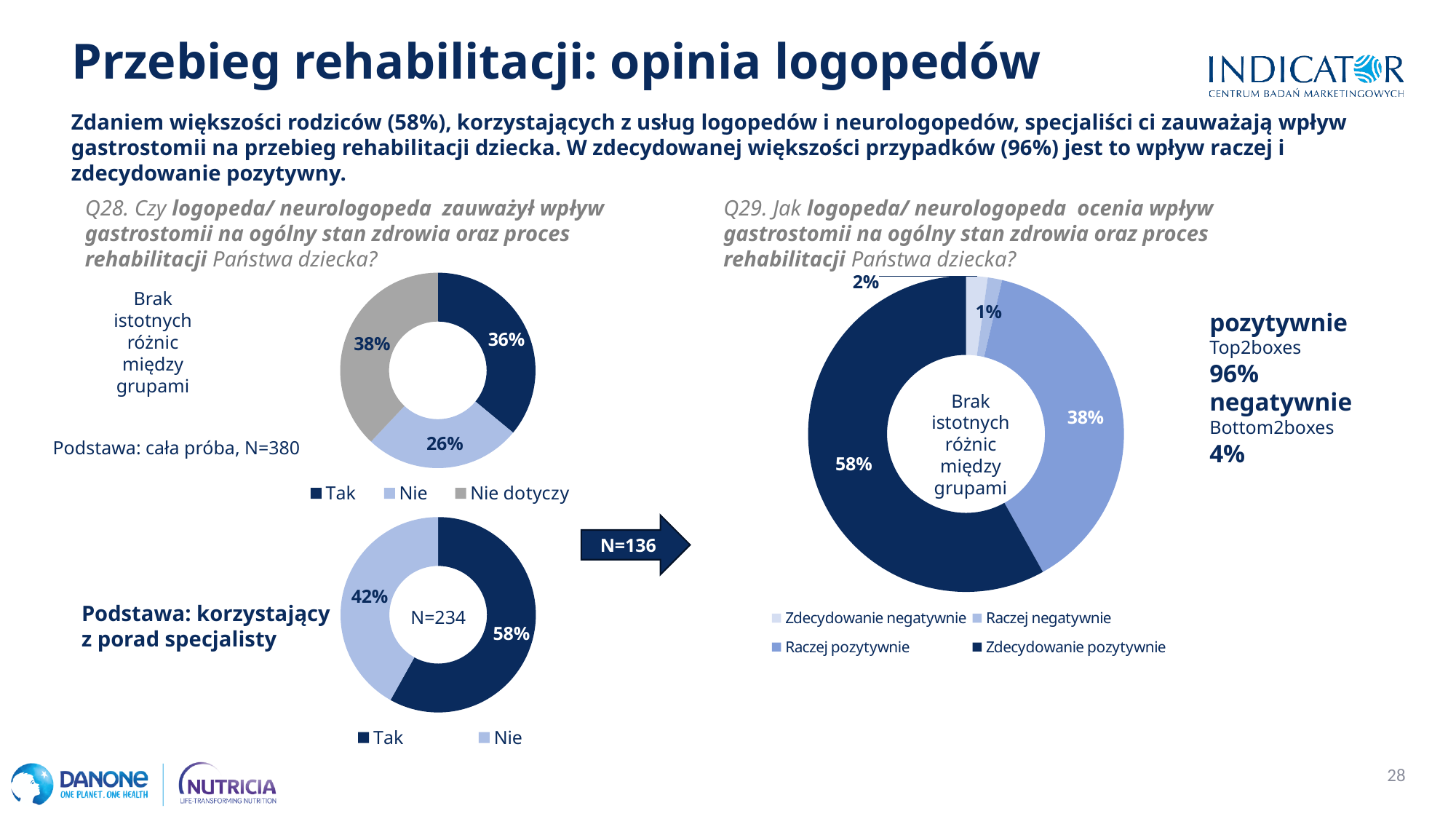
In the bottom-left donut chart (N=234), which is larger, 'Tak' or 'Nie'? Tak In the Q28 donut chart for the whole sample (N=380), which category has the lowest share? Nie What type of chart is used for the Q29 results on the right of the slide? Donut (pie) chart In the Q29 donut chart on the right, what is the combined share of 'Zdecydowanie pozytywnie' and 'Raczej pozytywnie'? 96% In the Q29 donut chart on the right, what percentage is 'Zdecydowanie pozytywnie'? 58% In the Q29 donut chart on the right, which category has the largest share? Zdecydowanie pozytywnie In the Q28 donut chart for the whole sample (N=380), how many categories does the legend list? 3 In the bottom-left donut chart (N=234), what is the difference between 'Tak' and 'Nie'? 16% In the Q28 donut chart for the whole sample (N=380), what percentage is 'Nie dotyczy'? 38% In the Q28 donut chart for the whole sample (N=380), what percentage answered 'Tak'? 36% In the Q29 donut chart on the right, what percentage is 'Raczej pozytywnie'? 38% In the bottom-left donut chart (N=234, respondents using a specialist), what percentage answered 'Tak'? 58%